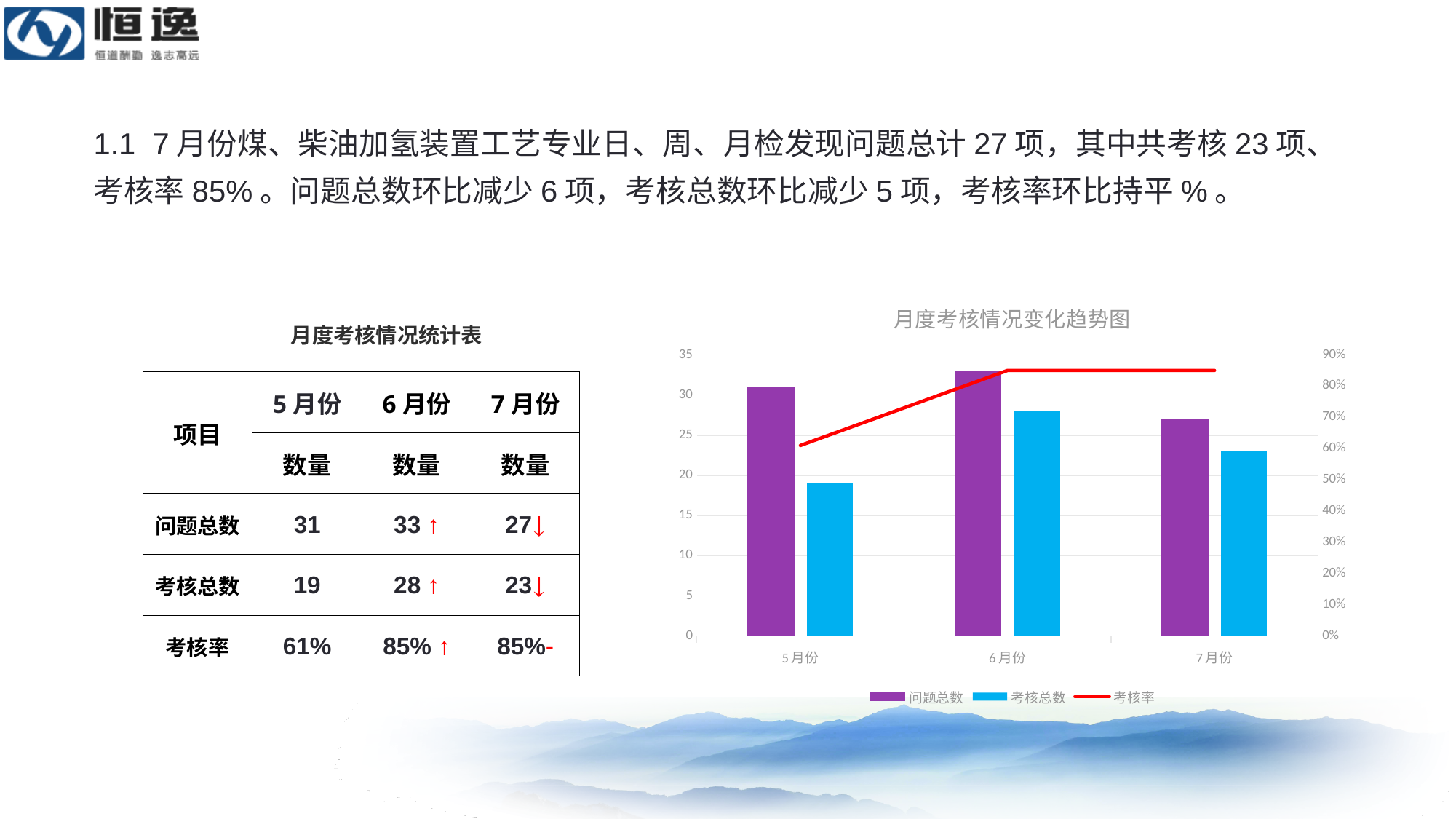
In 月度考核情况变化趋势图, what is the difference between 问题总数 and 考核总数 for 6月份? 5 In 月度考核情况变化趋势图, does the 考核率 line rise or fall from 5月份 to 6月份? rises What kind of chart is 月度考核情况变化趋势图? A bar chart with a line In 月度考核情况变化趋势图, is the 考核总数 value for 5月份 greater or less than 20? less In 月度考核情况变化趋势图, is the 问题总数 value for 5月份 greater or less than 30? greater What colour are the 考核总数 bars in 月度考核情况变化趋势图? Blue In 月度考核情况变化趋势图, what is the 问题总数 value for 7月份? 27 In 月度考核情况变化趋势图, which month has the lowest 考核总数 bar? 5月份 In 月度考核情况变化趋势图, which is larger: the 问题总数 for 6月份 or for 7月份? 6月份 How many series does the legend of 月度考核情况变化趋势图 list? 3 How many months are shown on the x axis of 月度考核情况变化趋势图? 3 In 月度考核情况变化趋势图, which month has the highest 问题总数 bar? 6月份